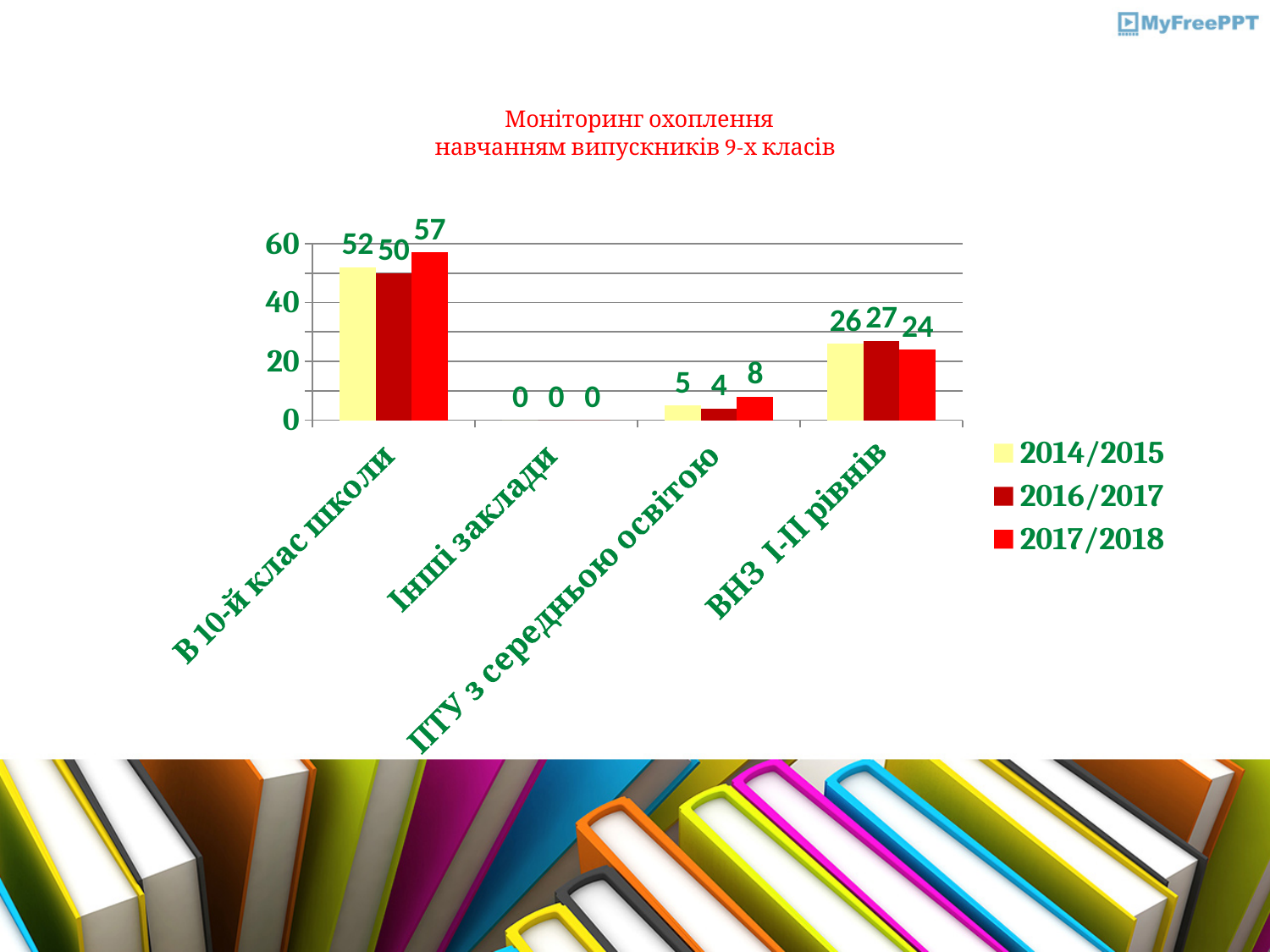
What is the difference between the 2017/2018 and 2016/2017 values for 'В 10-й клас школи'? 7 What is the value for 'В 10-й клас школи' in the 2017/2018 series? 57 Which category has the highest value in the 2017/2018 series? В 10-й клас школи Which series is shown in bright red in the legend? 2017/2018 How many categories are shown on the x axis? 4 Which category has the lowest value in the 2014/2015 series? Інші заклади How many series does the legend list? 3 What is the total of the three series values for 'ПТУ з середньою освітою'? 17 What kind of chart is shown on the slide? bar chart Which is larger for 'ВНЗ I-II рівнів': the 2016/2017 value or the 2017/2018 value? 2016/2017 What is the value for 'ПТУ з середньою освітою' in the 2016/2017 series? 4 What is the value for 'ВНЗ I-II рівнів' in the 2014/2015 series? 26